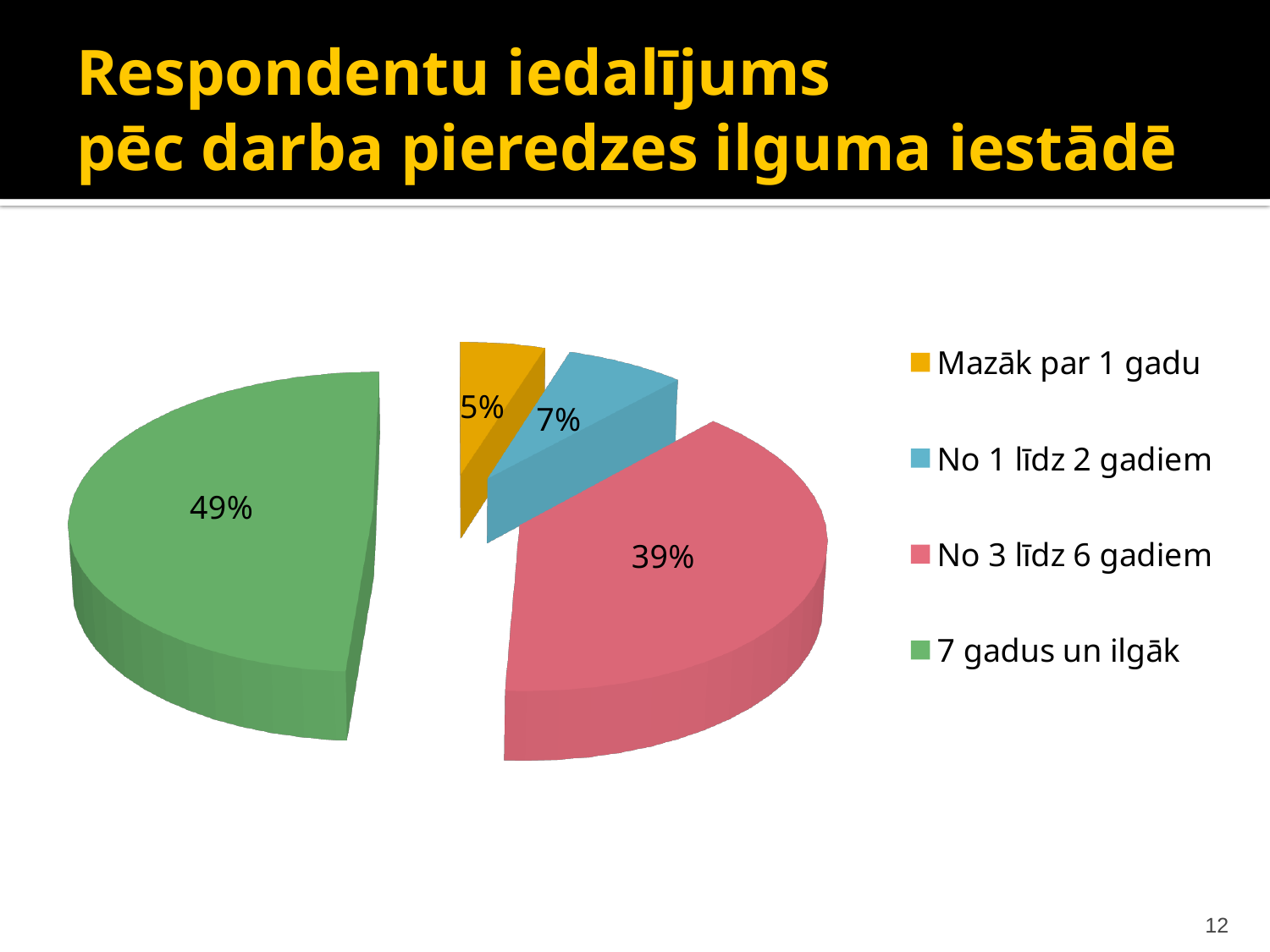
What is the difference in percentage points between the '7 gadus un ilgāk' and 'No 3 līdz 6 gadiem' shares? 10 percentage points What is the combined share of respondents with less than 1 year and 1 to 2 years of experience? 12% What share of respondents fall into the 'No 1 līdz 2 gadiem' category? 7% What colour is the slice for 'No 3 līdz 6 gadiem'? Red/pink What kind of chart is shown on the slide? Pie chart What share of respondents have less than 1 year of experience (Mazāk par 1 gadu)? 5% Which category has the smallest share of respondents? Mazāk par 1 gadu What share of respondents fall into the 'No 3 līdz 6 gadiem' category? 39% What share of respondents have worked at the institution for 7 years or longer (7 gadus un ilgāk)? 49% Which is larger: the share for 'No 1 līdz 2 gadiem' or the share for 'Mazāk par 1 gadu'? No 1 līdz 2 gadiem Which category has the largest share of respondents? 7 gadus un ilgāk How many categories does the pie chart show? 4